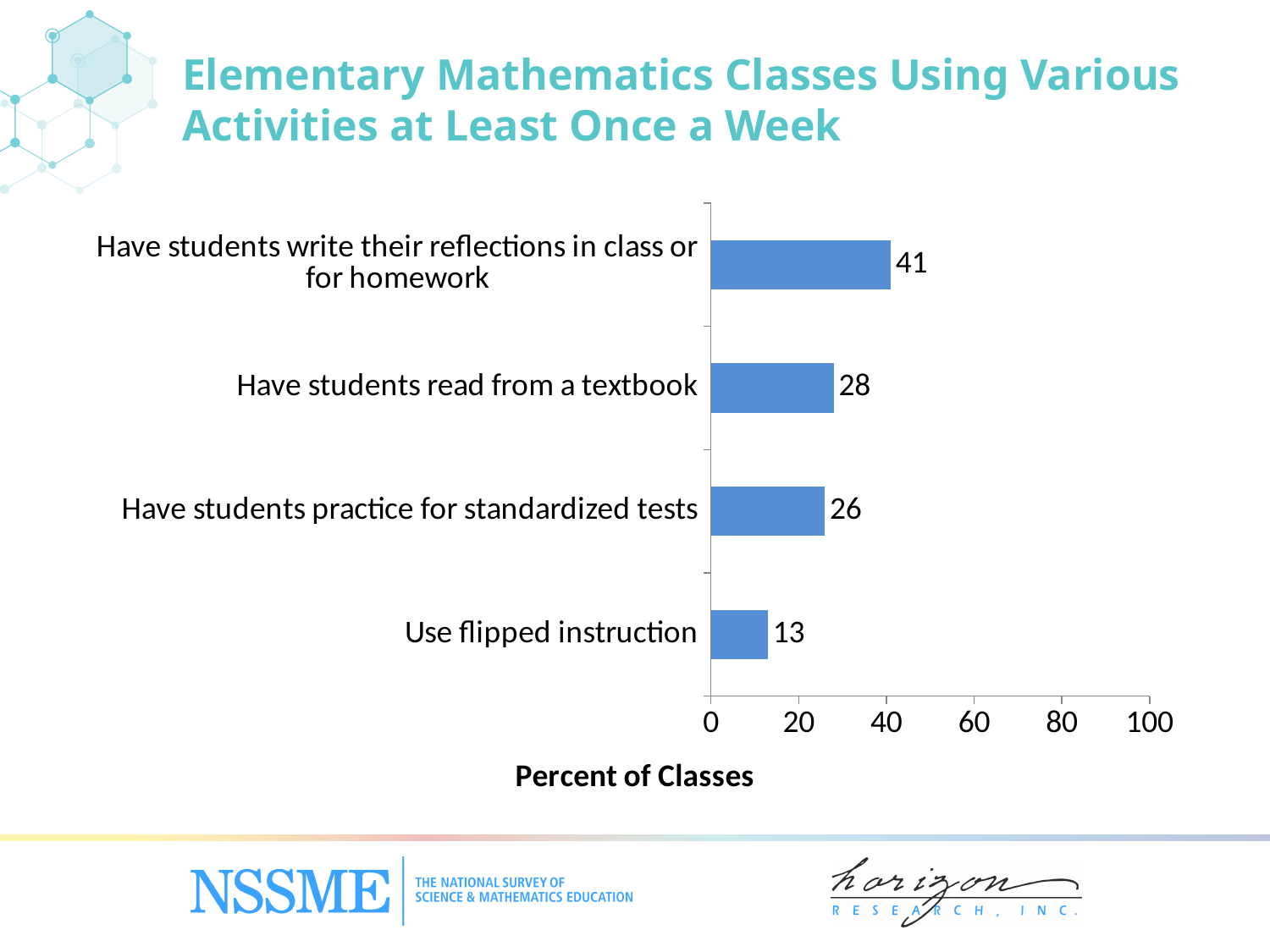
What percent of classes have students write their reflections in class or for homework at least once a week? 41 Which activity has the lowest percent of classes? Use flipped instruction What percent of classes use flipped instruction at least once a week? 13 What percent of classes have students read from a textbook at least once a week? 28 What is the label of the horizontal axis? Percent of Classes What kind of chart is shown on the slide? Bar chart What is the difference in percent of classes between having students write their reflections and using flipped instruction? 28 What is the difference in percent of classes between having students read from a textbook and having students practice for standardized tests? 2 Which has a higher percent of classes: having students read from a textbook or using flipped instruction? Have students read from a textbook What percent of classes have students practice for standardized tests at least once a week? 26 How many activities are shown in the chart? 4 Which activity has the highest percent of classes? Have students write their reflections in class or for homework